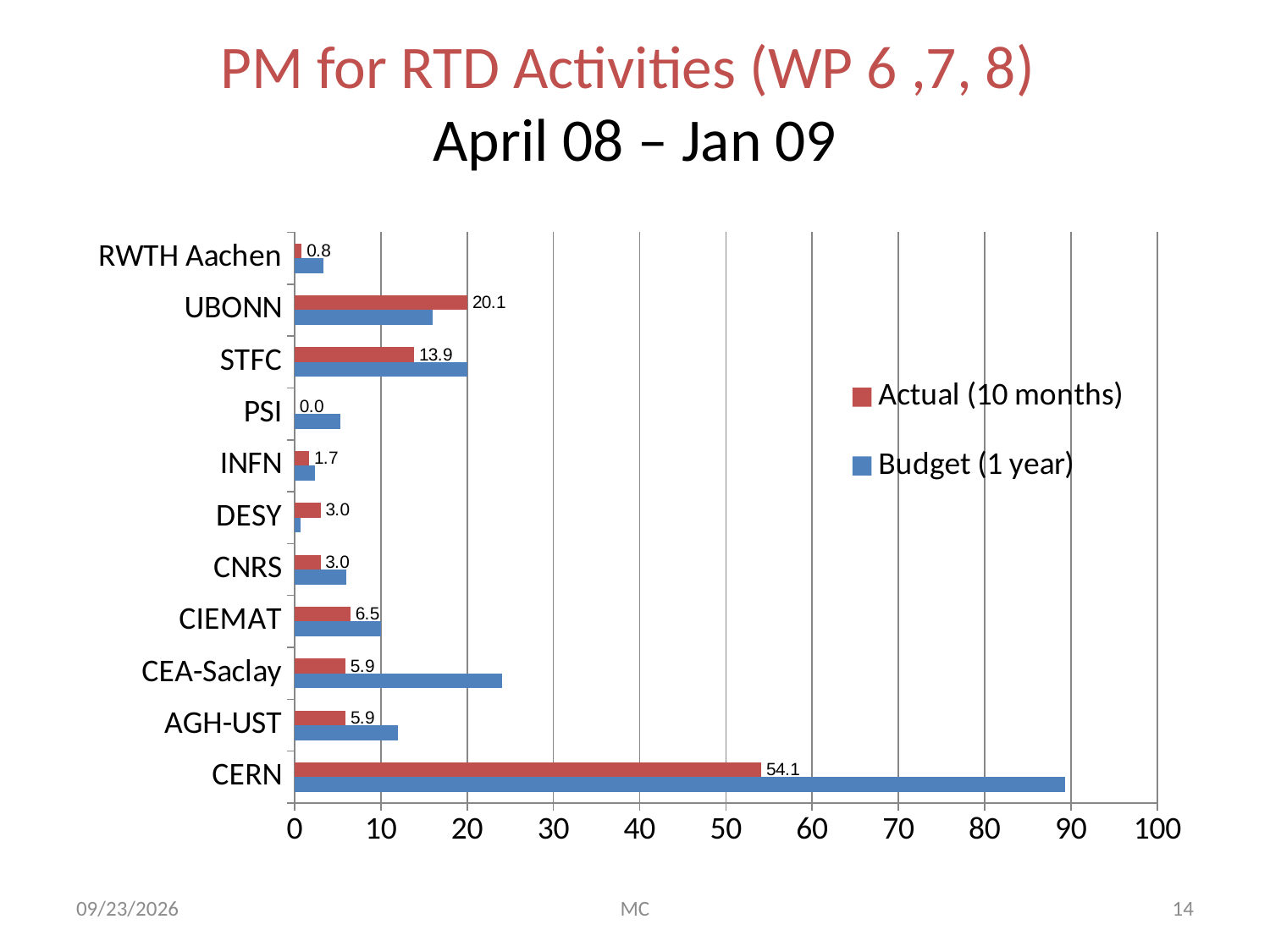
What kind of chart is shown on the slide? Bar chart How many institutes are shown on the chart? 11 How many series does the legend list? 2 Which institute has the lowest Actual (10 months) value? PSI Is the Budget (1 year) value for CERN greater or less than 80? greater What is the Actual (10 months) value for UBONN? 20.1 What is the Actual (10 months) value for CERN? 54.1 What is the difference between the Actual (10 months) values for UBONN and STFC? 6.2 Which has the larger Actual (10 months) value, CIEMAT or CEA-Saclay? CIEMAT Is the Budget (1 year) value for CEA-Saclay greater or less than 20? greater What is the Actual (10 months) value for STFC? 13.9 Which institute has the highest Actual (10 months) value? CERN